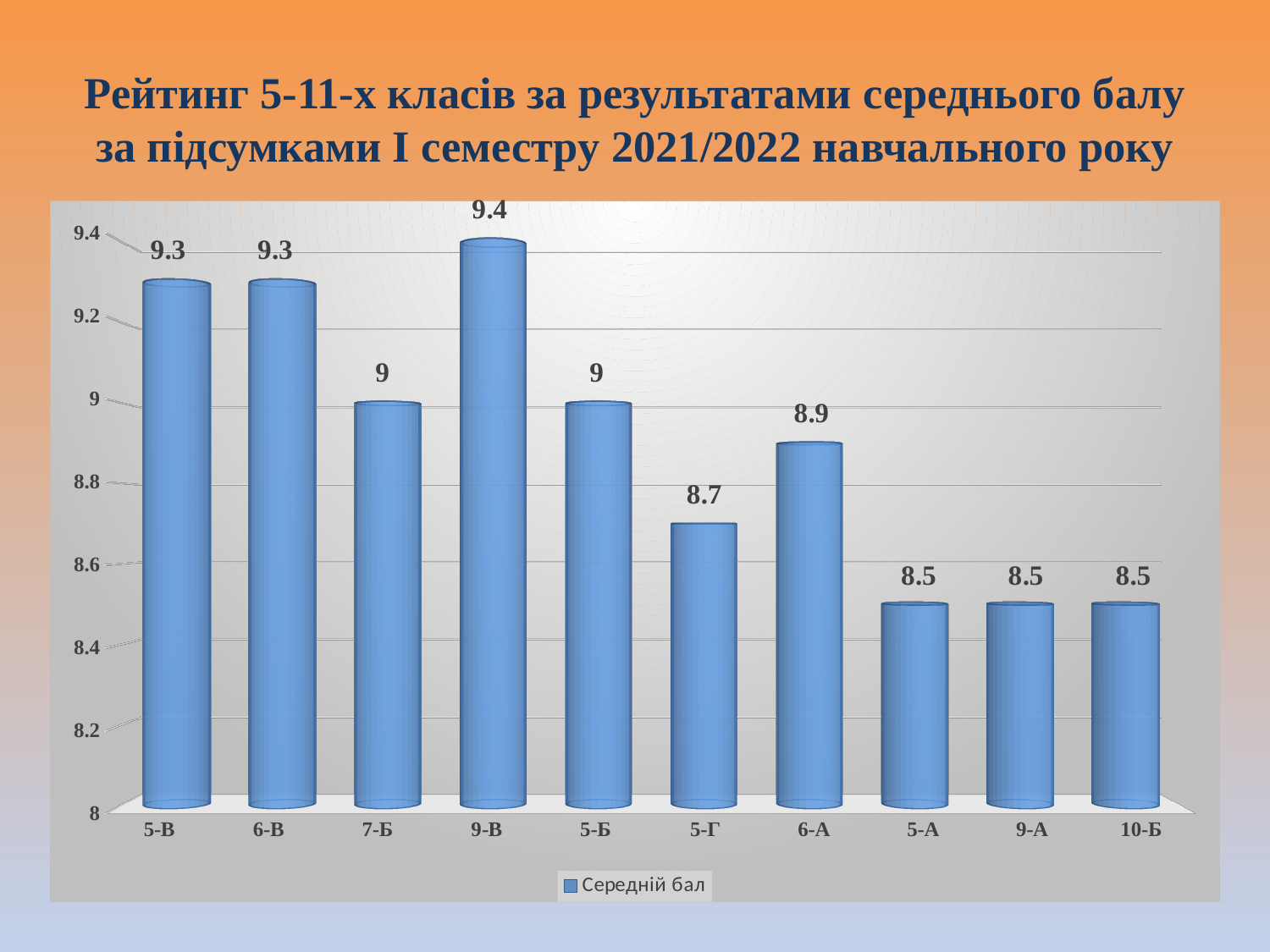
Which class has the highest average score? 9-В Is the value for 6-А greater or less than 9? less What is the difference between the values for 9-В and 5-А? 0.9 How many classes are shown on the x axis? 10 How many series does the legend list? 1 What is the value shown for class 6-А? 8.9 What is the average score (Середній бал) for class 9-В? 9.4 Which is larger, the value for 5-Б or the value for 5-Г? 5-Б What is the difference between the values for 5-В and 7-Б? 0.3 What is the legend entry for the series? Середній бал What is the value shown for class 5-Г? 8.7 What kind of chart is shown on the slide? bar chart